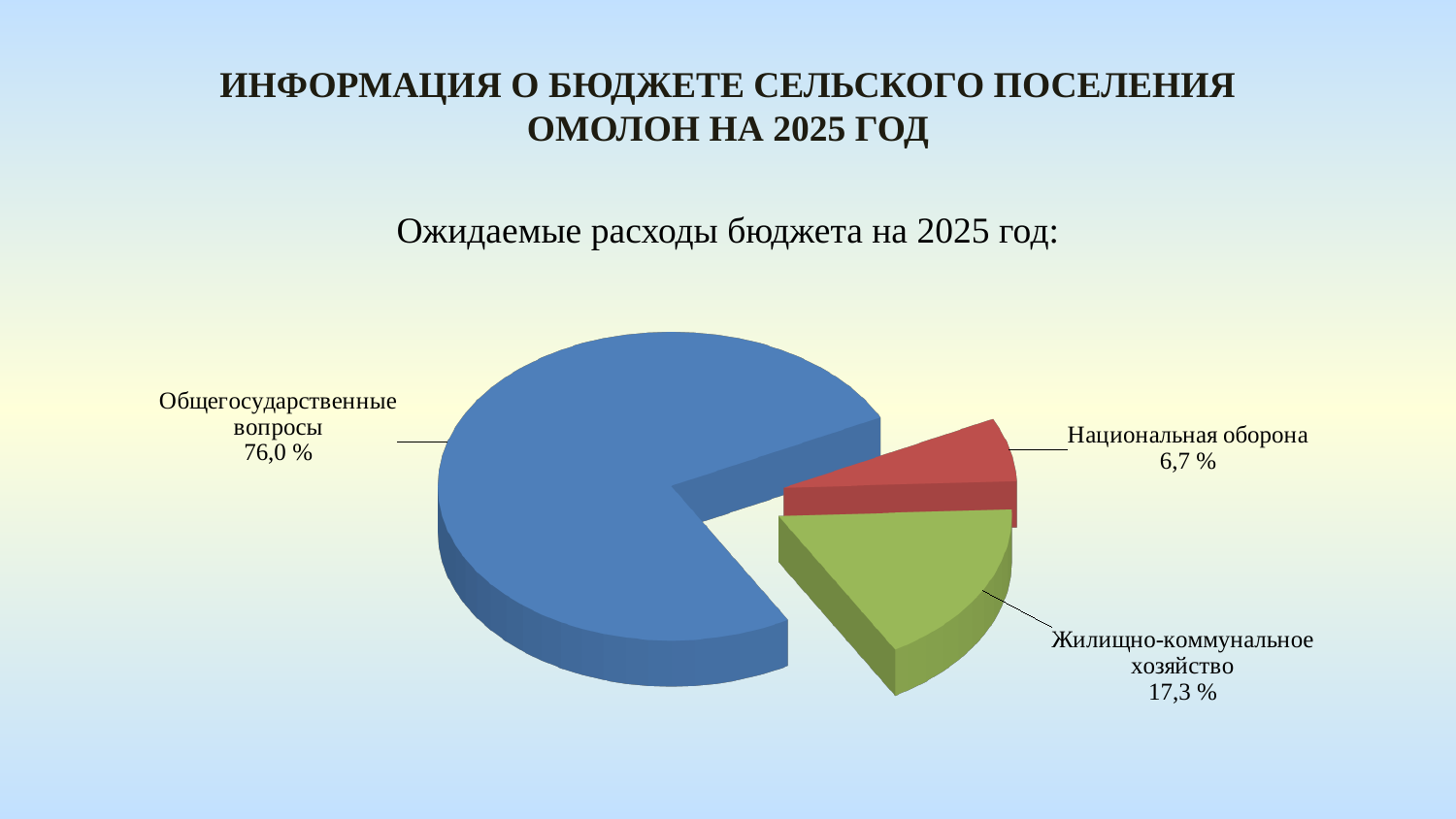
Which category has the smallest slice of the pie? Национальная оборона Which category has the largest slice of the pie? Общегосударственные вопросы What is the difference between the shares of Общегосударственные вопросы and Жилищно-коммунальное хозяйство? 58,7 % What share of the pie does Жилищно-коммунальное хозяйство have? 17,3 % How many categories are shown in the pie chart? 3 What is the title of the chart? Ожидаемые расходы бюджета на 2025 год: What kind of chart is shown on the slide? Pie chart What share of the pie does Национальная оборона have? 6,7 % What share of the pie does Общегосударственные вопросы have? 76,0 % Which is larger, the share of Жилищно-коммунальное хозяйство or the share of Национальная оборона? Жилищно-коммунальное хозяйство What colour is the slice for Национальная оборона? Red What is the difference between the shares of Жилищно-коммунальное хозяйство and Национальная оборона? 10,6 %